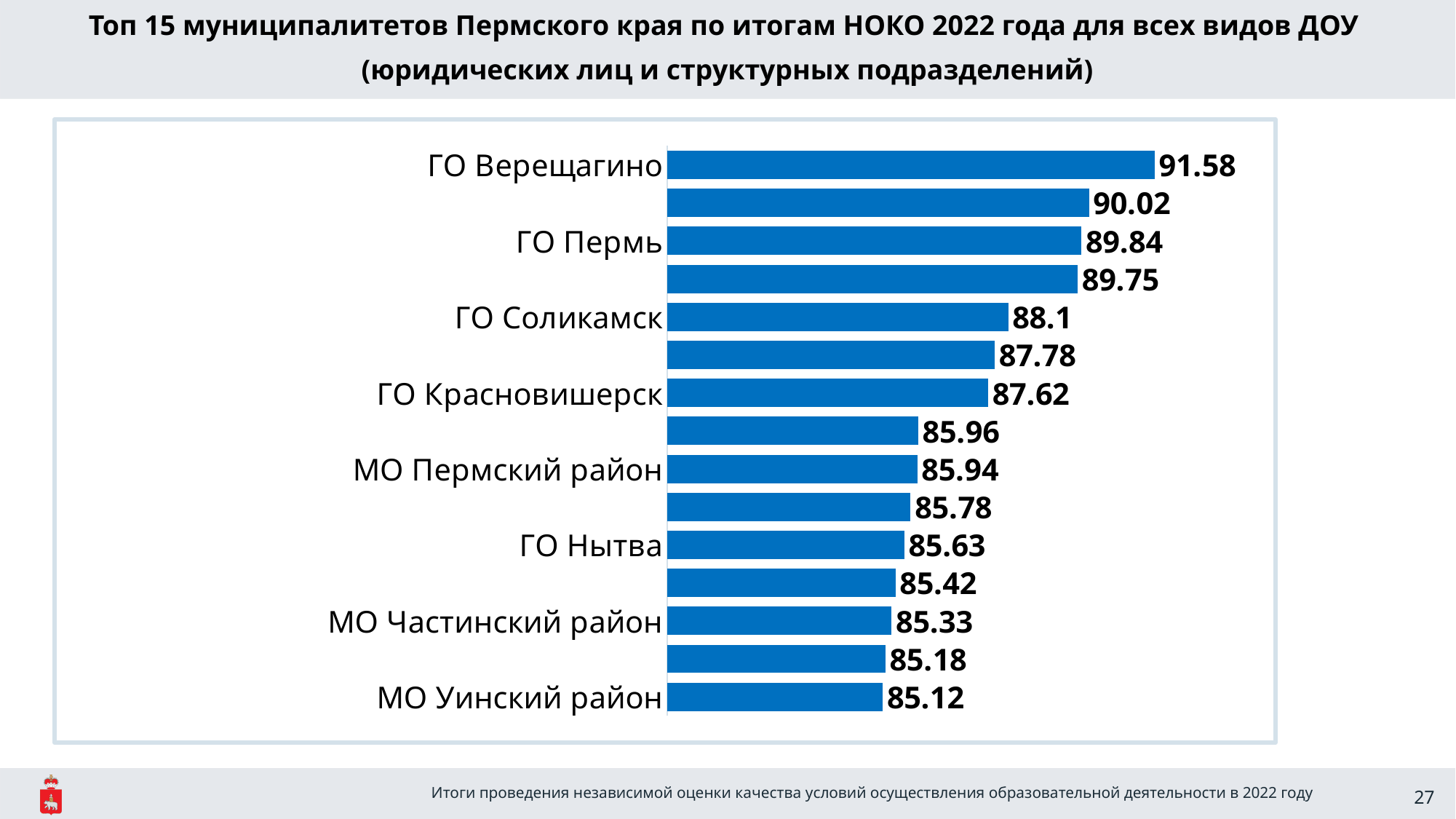
Which labelled municipality has the lowest value? МО Уинский район What kind of chart is shown on the slide? bar chart What is the value for ГО Соликамск? 88.1 What is the difference between the values for ГО Верещагино and МО Уинский район? 6.46 Which labelled municipality has the highest value? ГО Верещагино What is the difference between the values for ГО Пермь and ГО Соликамск? 1.74 How many bars are plotted in the chart? 15 Do the bar values increase or decrease going from the top of the chart to the bottom? decrease What is the value for МО Уинский район? 85.12 What is the value for ГО Верещагино? 91.58 Which has a larger value, ГО Красновишерск or МО Пермский район? ГО Красновишерск What is the value for ГО Пермь? 89.84